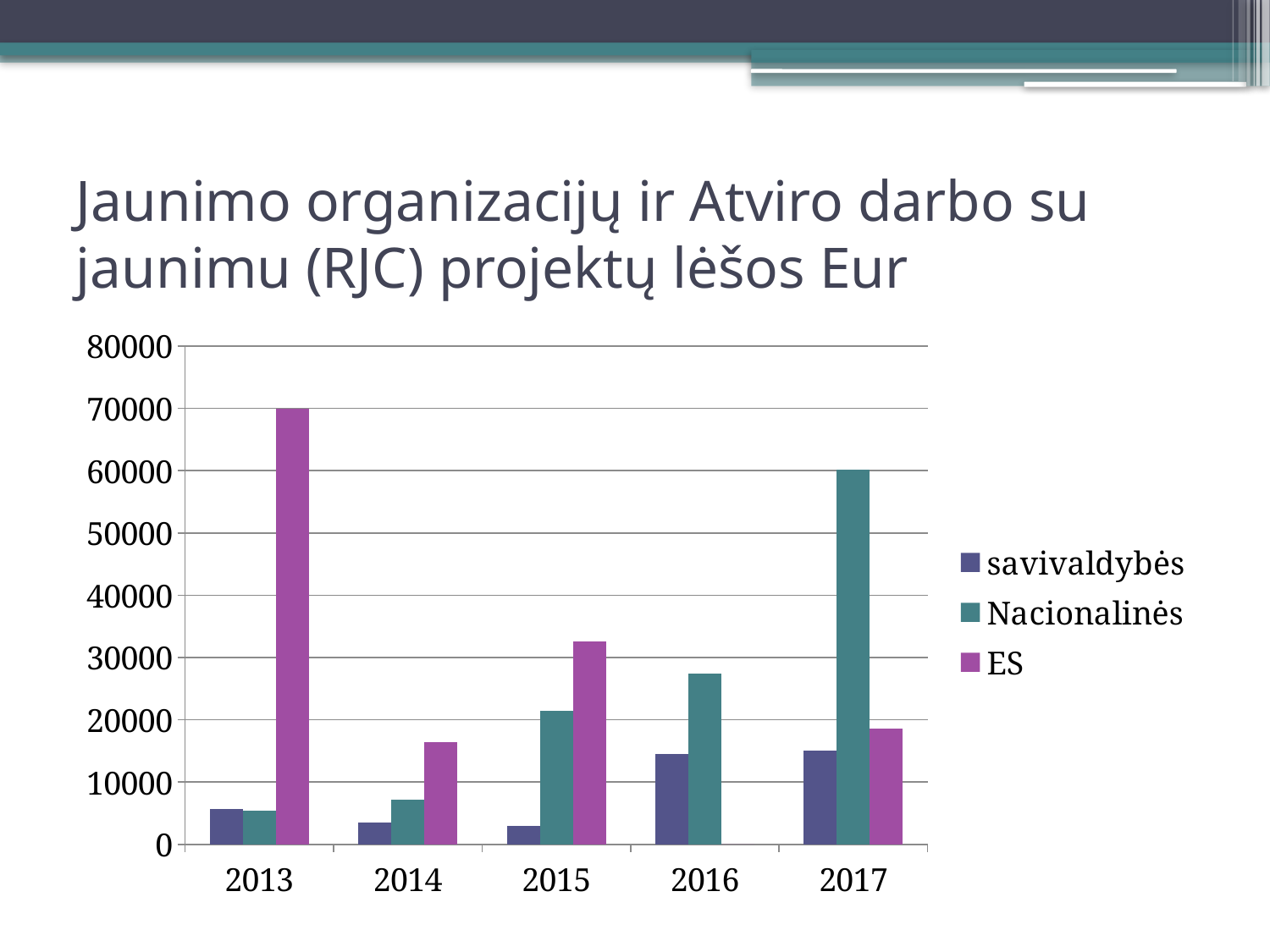
How many series does the legend list? 3 Which is larger in 2016, savivaldybės or Nacionalinės? Nacionalinės In which year is the ES value highest? 2013 Is the value for ES in 2015 greater or less than 30000? greater Do the Nacionalinės values rise or fall from 2013 to 2017? rise Is the value for savivaldybės in 2014 greater or less than 10000? less In which year is the Nacionalinės value highest? 2017 How many years are shown on the x axis? 5 What kind of chart is shown on the slide? bar chart Which year has no ES bar? 2016